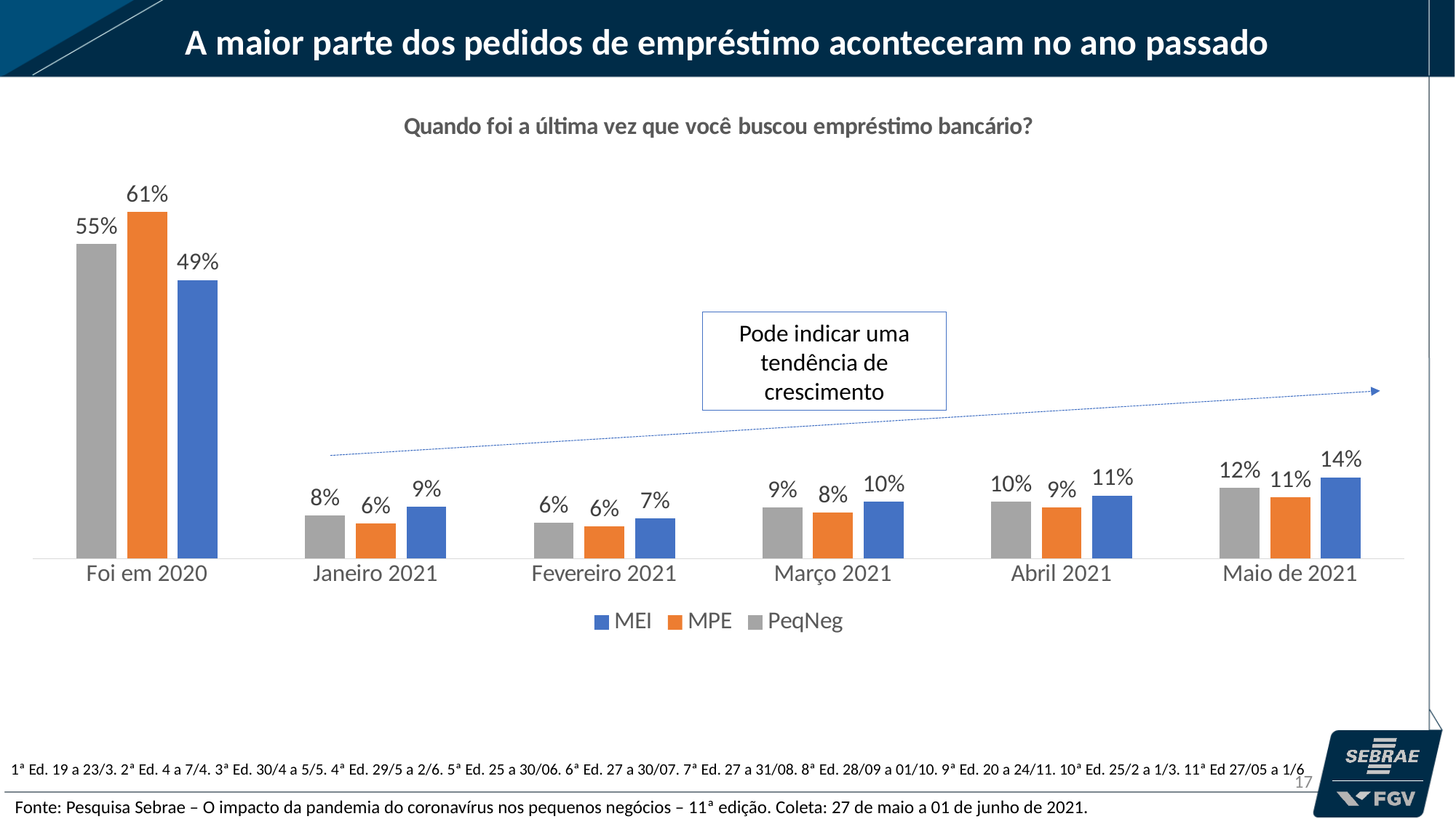
Which colour represents the MPE series in the legend? Orange Which is larger for Março 2021, the MEI value or the MPE value? MEI What is the difference between the MPE and MEI values for "Foi em 2020"? 12% What is the PeqNeg value for Abril 2021? 10% How many series does the legend list? 3 What is the MPE value for "Foi em 2020"? 61% How many categories are shown on the x axis? 6 What is the MEI value for Maio de 2021? 14% Which category has the lowest PeqNeg value? Fevereiro 2021 From Janeiro 2021 to Maio de 2021, do the MEI values rise or fall? Rise Which category has the highest MEI value? Foi em 2020 What kind of chart is shown on the slide? Bar chart